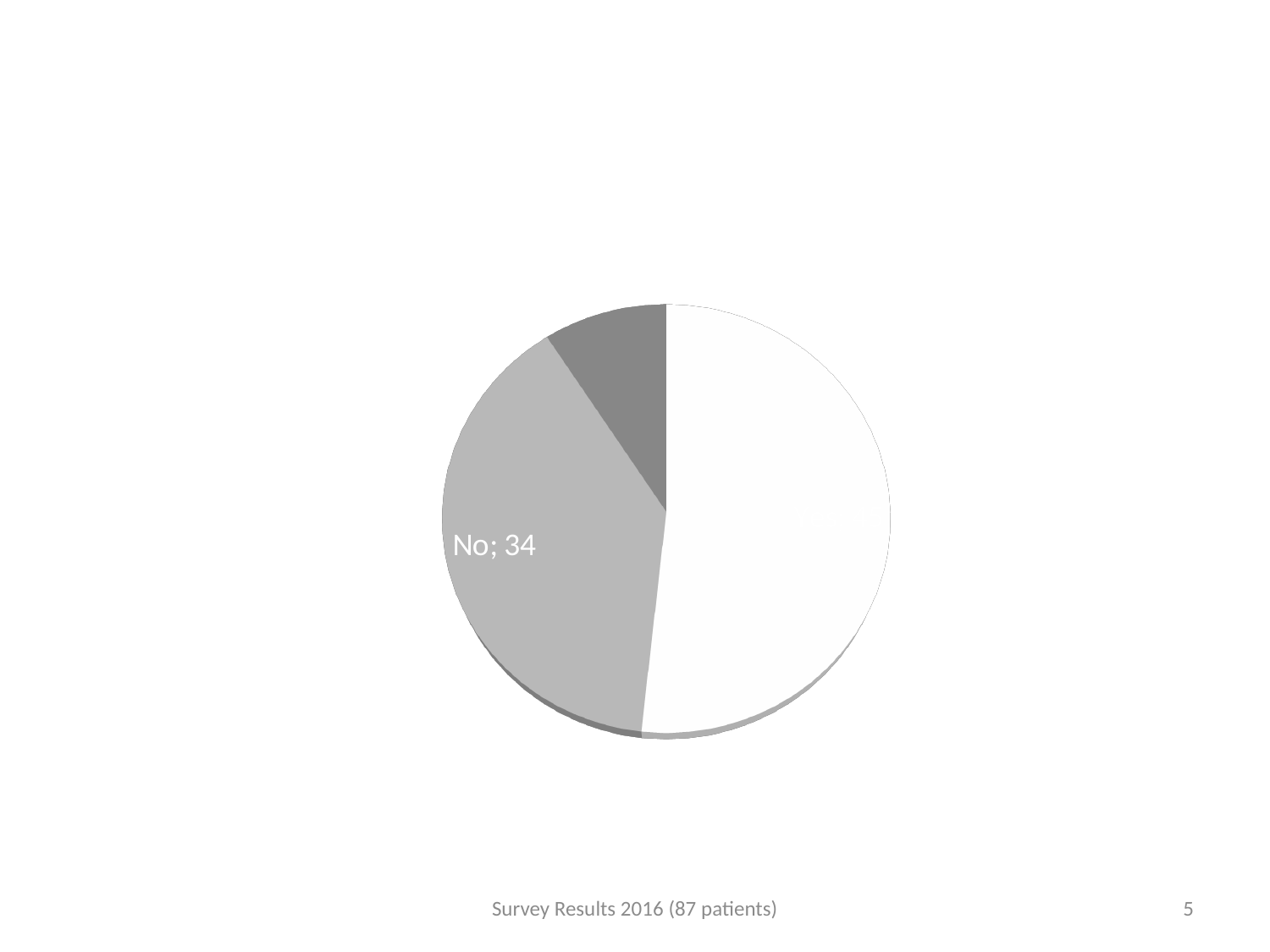
Is the 'No' slice the largest slice of the pie chart? No Does the 'No' slice cover more or less than half of the pie? less What kind of chart is shown on the slide? pie chart How many slices does the pie chart have? 3 What is the value shown for the 'No' slice of the pie chart? 34 What colour is the slice labelled 'No' in the pie chart? light gray